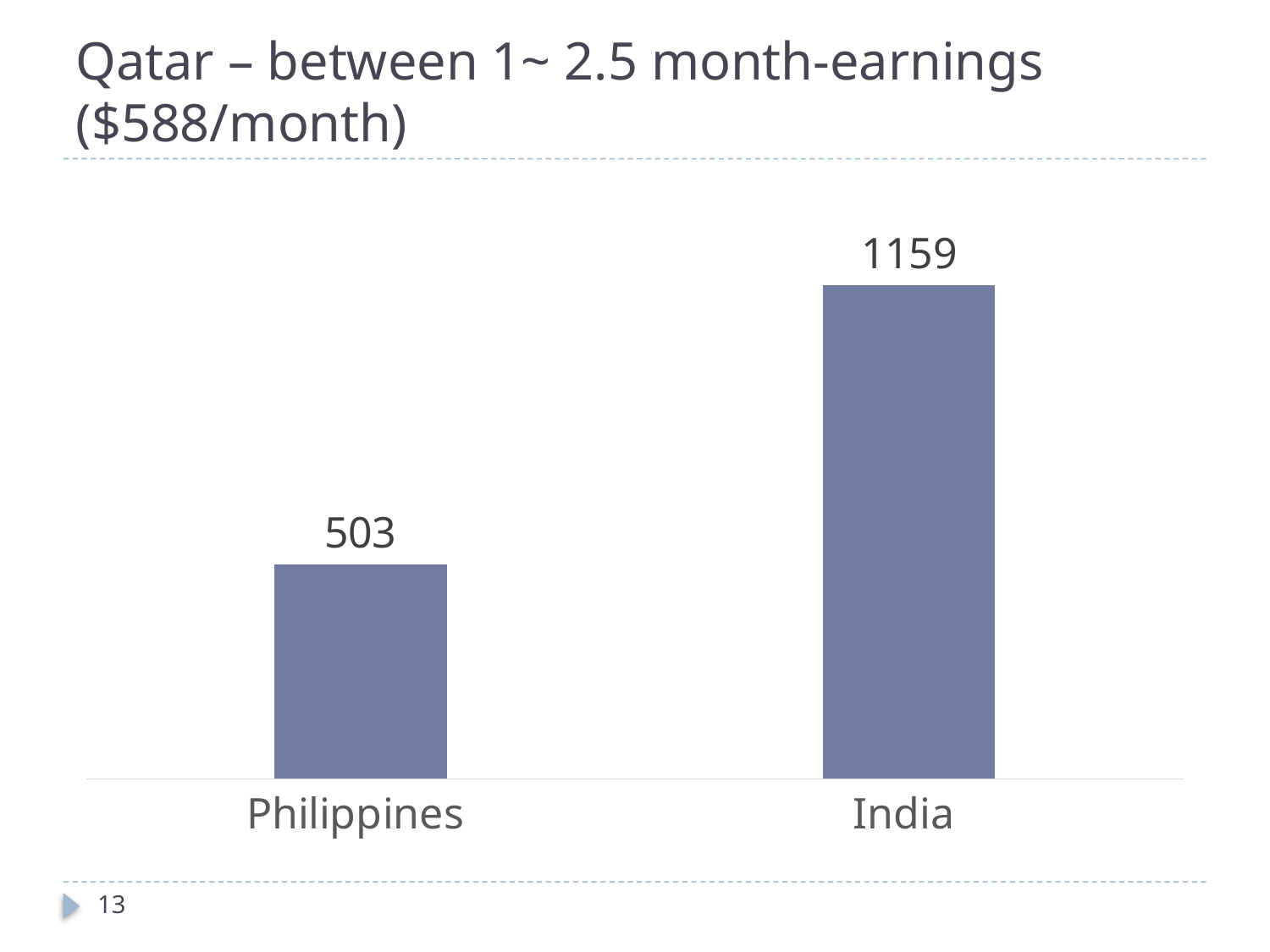
Which category has the lowest value? Philippines Which is larger, the value for Philippines or the value for India? India What colour are the bars in the chart? blue-grey What kind of chart is shown on the slide? bar chart How many categories are shown in the chart? 2 What is the total of the two values shown in the chart? 1662 Which category has the highest value? India What is the difference between the values for India and Philippines? 656 What is the title of the slide? Qatar – between 1~ 2.5 month-earnings ($588/month) What is the value for India? 1159 What is the value for Philippines? 503